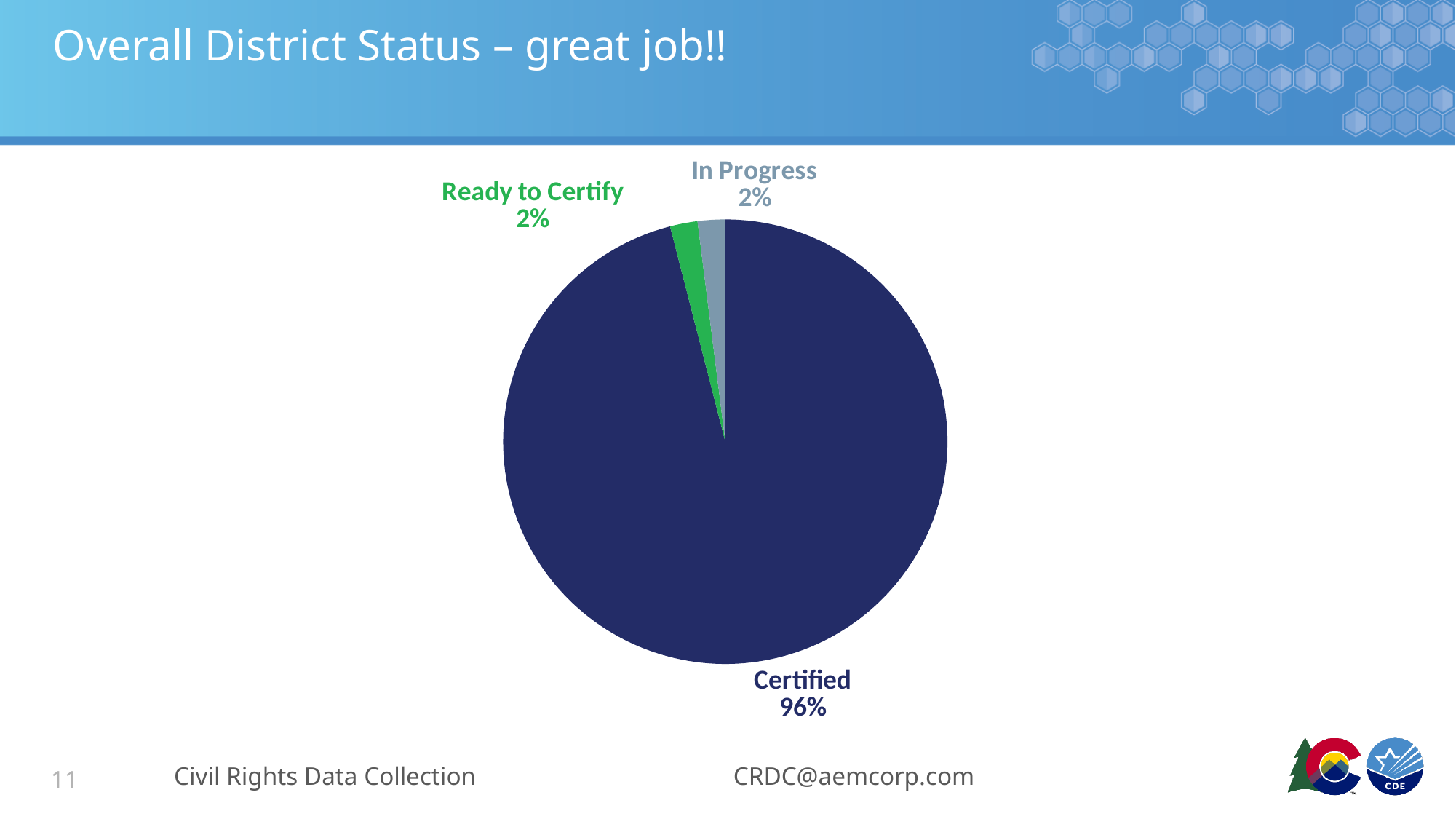
What share of districts are In Progress? 2% What share of districts are Ready to Certify? 2% What kind of chart is shown on the slide? pie chart How many slices does the pie chart have? 3 What is the difference in percentage points between the Certified share and the In Progress share? 94 Which status has the largest share of the pie? Certified What share of districts are Certified? 96% Which is larger, the Certified share or the Ready to Certify share? Certified What colour is the Certified slice? dark navy blue What is the combined share of Ready to Certify and In Progress? 4% What colour is the Ready to Certify slice? green